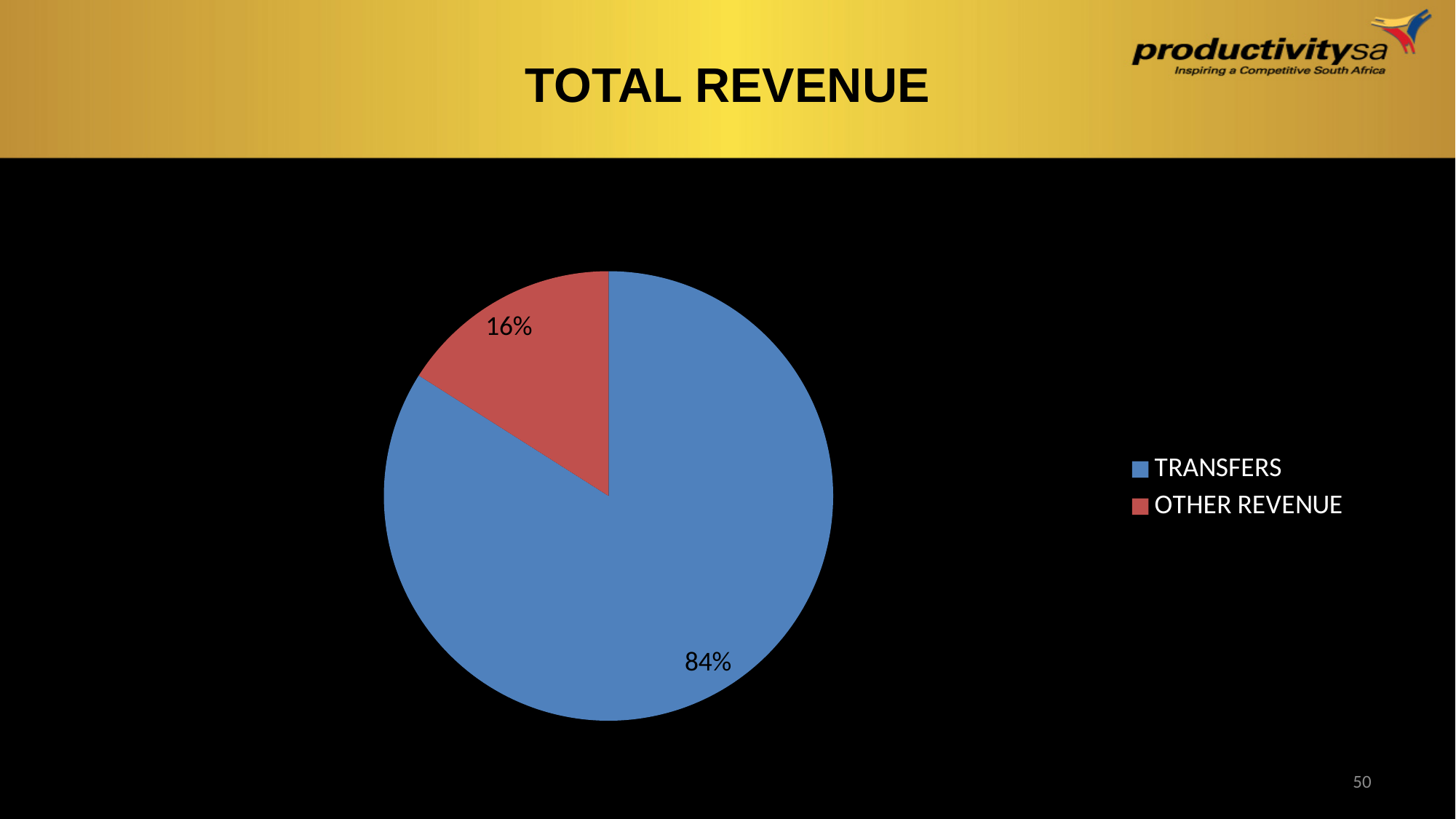
What share of total revenue comes from TRANSFERS? 84% What kind of chart is shown on the slide? pie chart Which category has the largest slice of the pie? TRANSFERS Which category has the smallest slice of the pie? OTHER REVENUE How many entries does the legend list? 2 What is the title of the slide containing the pie chart? TOTAL REVENUE How many slices does the pie chart have? 2 What share of total revenue comes from OTHER REVENUE? 16% What colour is the OTHER REVENUE slice? red What is the difference in percentage points between the TRANSFERS slice and the OTHER REVENUE slice? 68 Which is larger, the TRANSFERS slice or the OTHER REVENUE slice? TRANSFERS